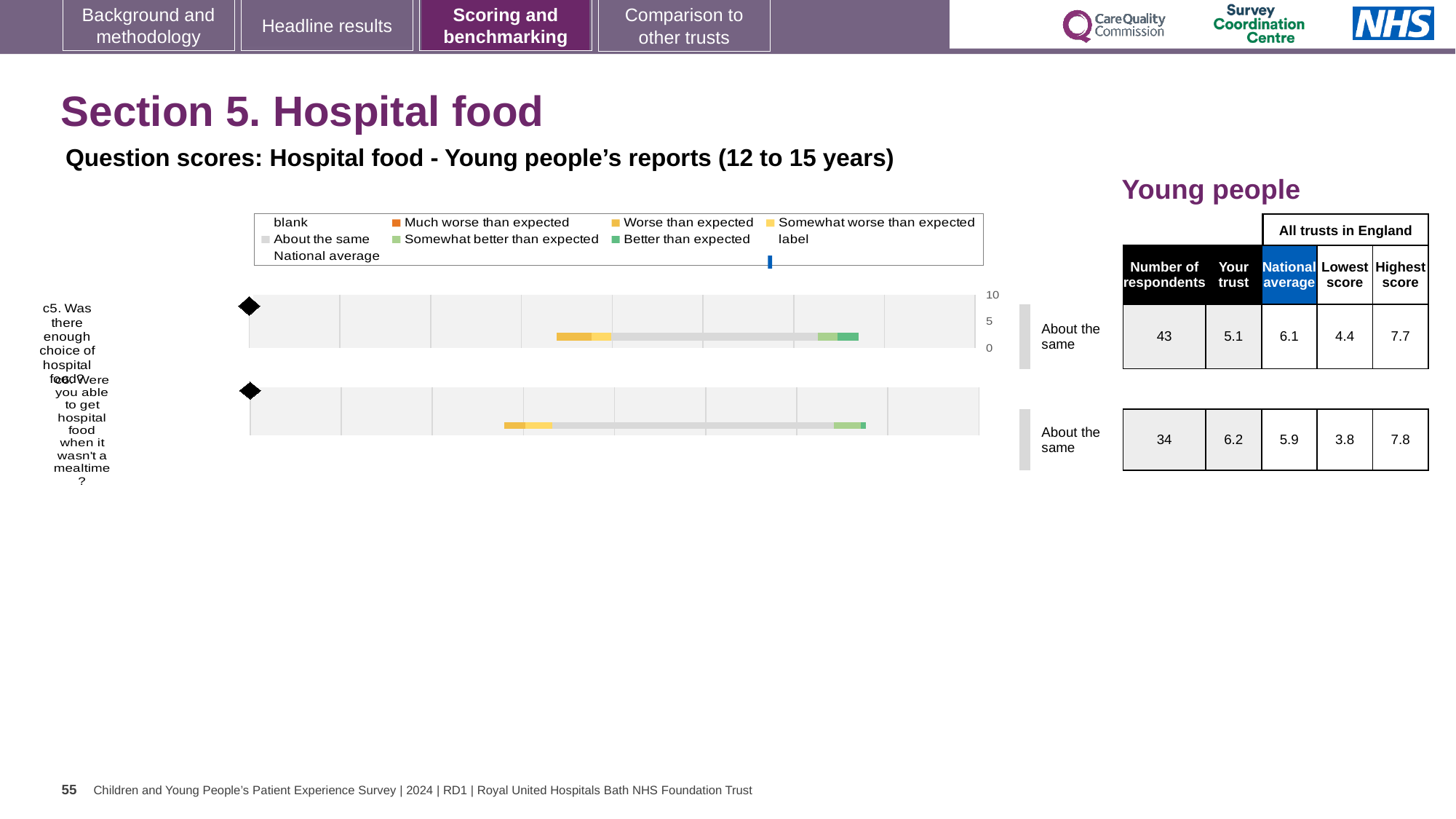
What kind of chart is used to show the question scores for hospital food? bar chart What is the 'Your trust' score for question c5 (Was there enough choice of hospital food?)? 5.1 What is the highest score among all trusts in England for question c6? 7.8 What is the difference between the highest score and the lowest score for question c5? 3.3 What is the national average score for question c5? 6.1 What benchmark category is shown for question c6? About the same In the chart legend, what colour represents 'Much worse than expected'? orange How many respondents answered question c6? 34 What is the 'Your trust' score for question c6 (Were you able to get hospital food when it wasn't a mealtime?)? 6.2 In the chart legend, what colour represents 'Better than expected'? green How many questions (categories) are plotted in the hospital food chart? 2 For question c5, which is larger: the 'Your trust' score or the national average? national average